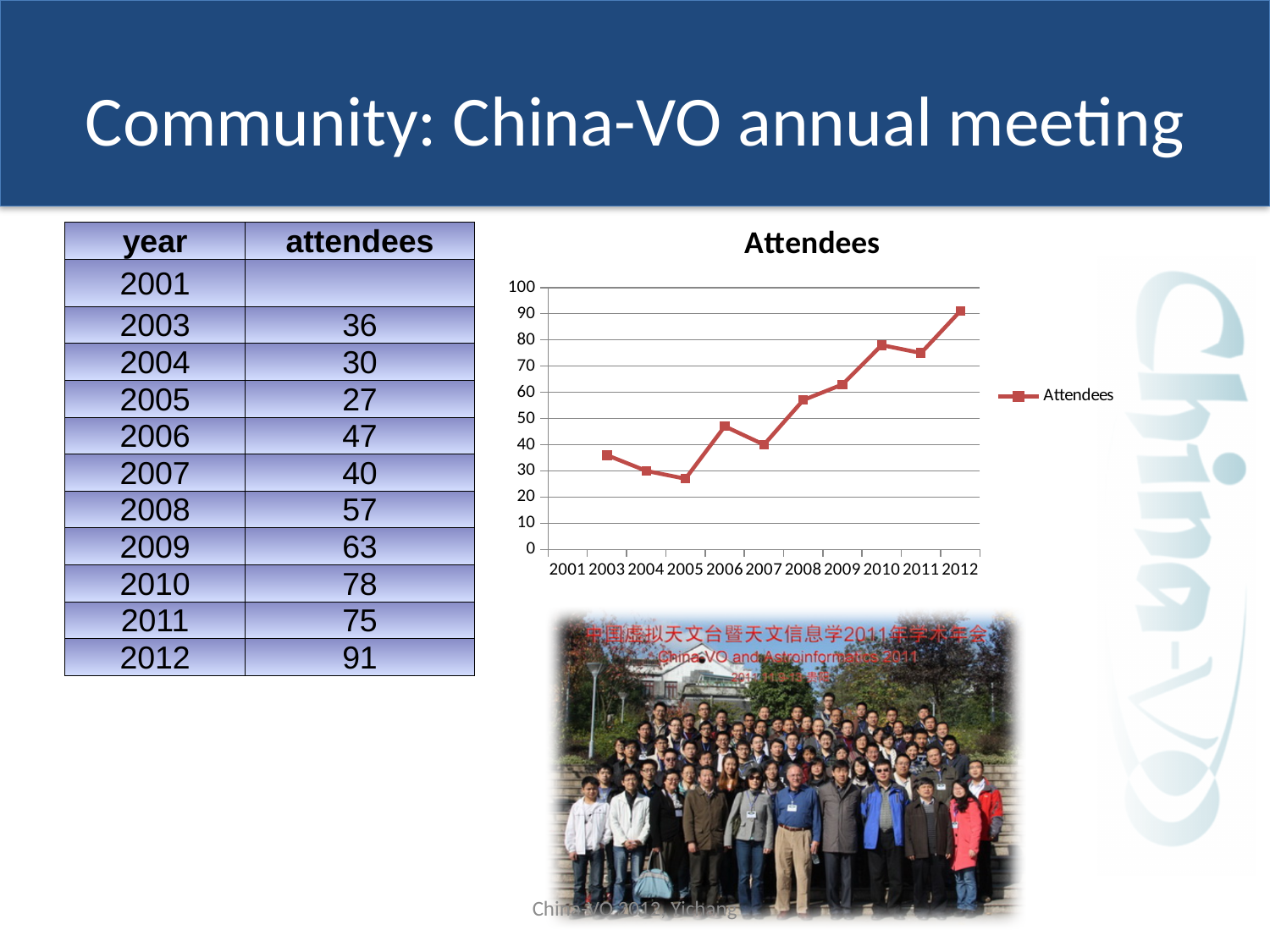
Is the value for 2010 greater or less than 70? greater What is the number of attendees for 2012? 91 Which year has more attendees, 2010 or 2011? 2010 What type of chart is shown on the slide? line chart Is the value for 2007 greater or less than 50? less What is the difference in attendees between 2012 and 2003? 55 What is the title of the chart? Attendees How many series does the chart legend list? 1 Which year has the lowest number of attendees in the chart? 2005 How many year labels are shown on the x axis of the chart? 11 What is the number of attendees for 2005? 27 Which year has the highest number of attendees in the chart? 2012